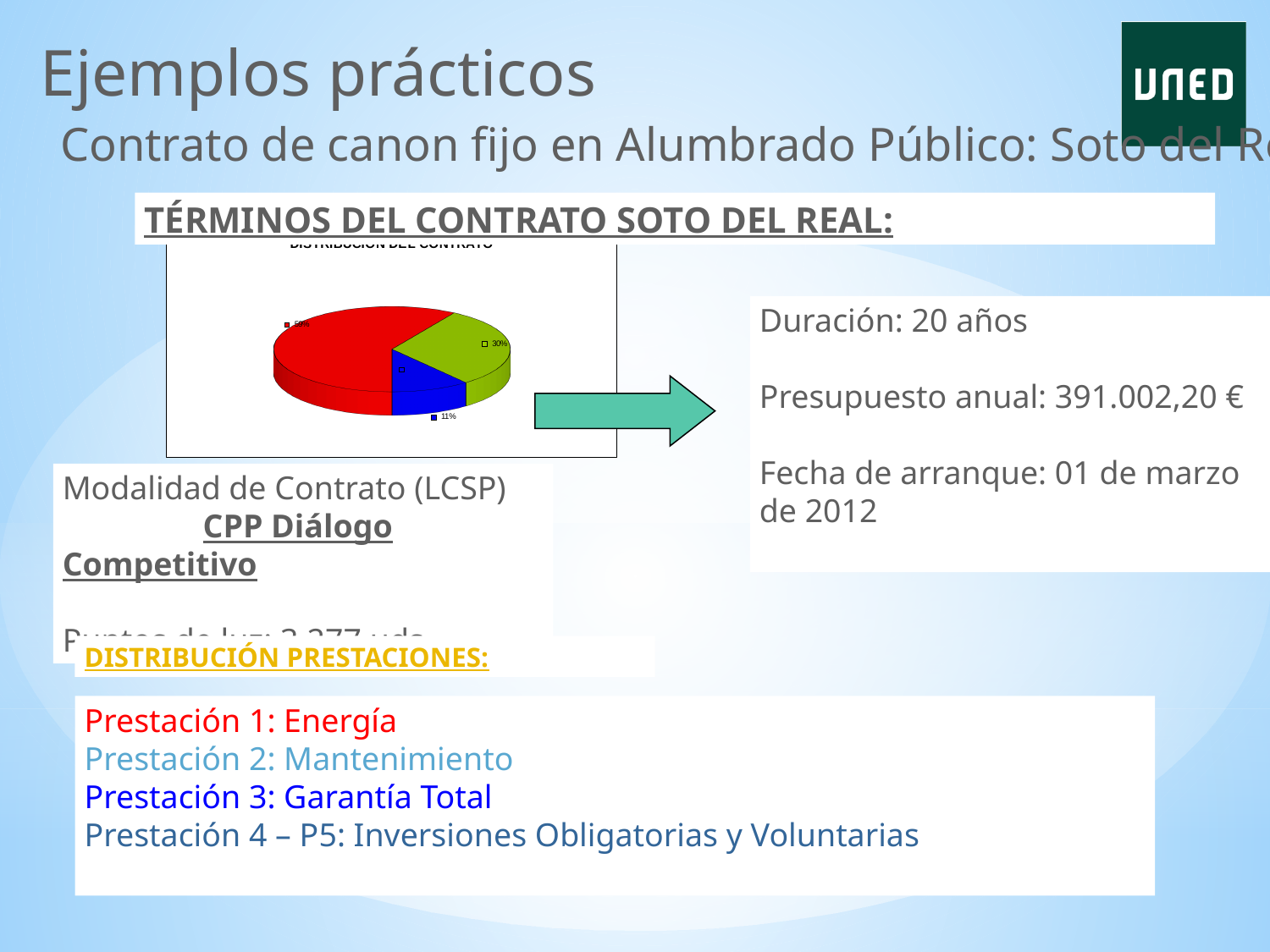
By how many percentage points does the red slice exceed the green slice? 29 Which slice of the pie chart is the smallest? the blue slice What share of the pie does the blue slice represent? 11% What is the title of the pie chart? DISTRIBUCIÓN DEL CONTRATO By how many percentage points does the green slice exceed the blue slice? 19 What share of the pie does the green slice represent? 30% Which is larger in the pie chart, the green slice or the blue slice? the green slice Which slice of the pie chart is the largest? the red slice What kind of chart is shown on the slide? pie chart How many slices does the pie chart have? 3 What share of the pie does the red slice represent? 59% What colour is the slice labelled 11%? blue